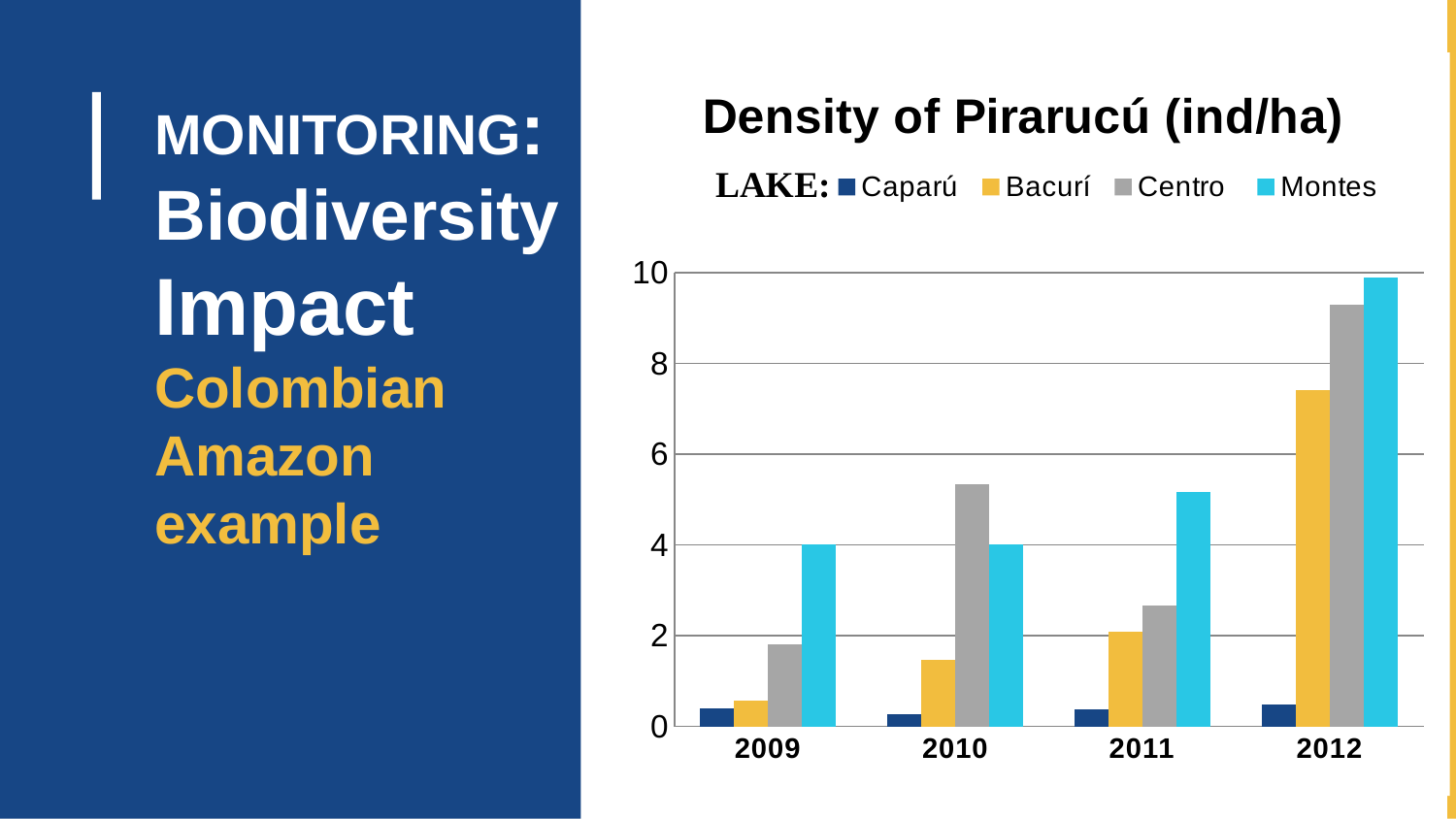
Which is larger in 2011, the value for Centro or the value for Montes? Montes Does the density for Bacurí rise or fall from 2009 to 2012? rise What type of chart is shown on the slide? bar chart Which lake has the highest density in 2010? Centro Is the value for Centro in 2010 greater or less than 4? greater Which lake has the lowest density in 2012? Caparú What is the title of the chart? Density of Pirarucú (ind/ha) Is the value for Bacurí in 2010 greater or less than 2? less How many series does the legend list? 4 Which lake has the highest density in 2012? Montes How many years are shown on the x axis? 4 Is the value for Montes in 2012 greater or less than 8? greater